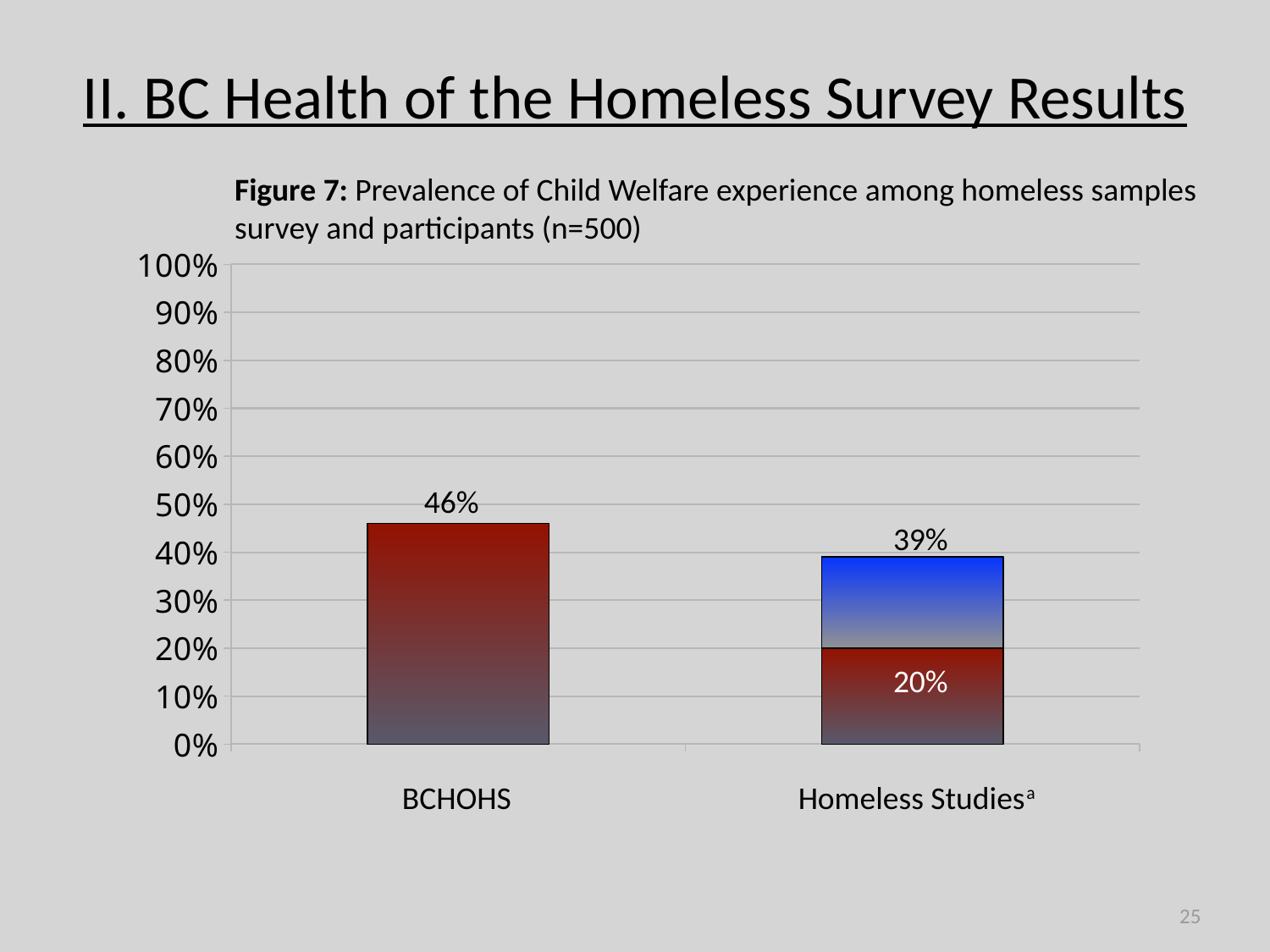
What value is labelled on the lower (red) segment of the Homeless Studies bar? 20% Which category has the taller bar, BCHOHS or Homeless Studies? BCHOHS Is the top of the Homeless Studies bar greater or less than 50%? less What kind of chart is shown on the slide? Bar chart What sample size (n) is stated in the chart title? n=500 What is the figure number given in the chart title? Figure 7 What is the difference between the BCHOHS value (46%) and the top value of the Homeless Studies bar (39%)? 7% What value is shown for BCHOHS? 46% What value is labelled at the top of the Homeless Studies bar? 39% How many categories are shown on the x axis? 2 Is the value for BCHOHS greater or less than 40%? greater Is the value for BCHOHS larger or smaller than the top value of the Homeless Studies bar? larger